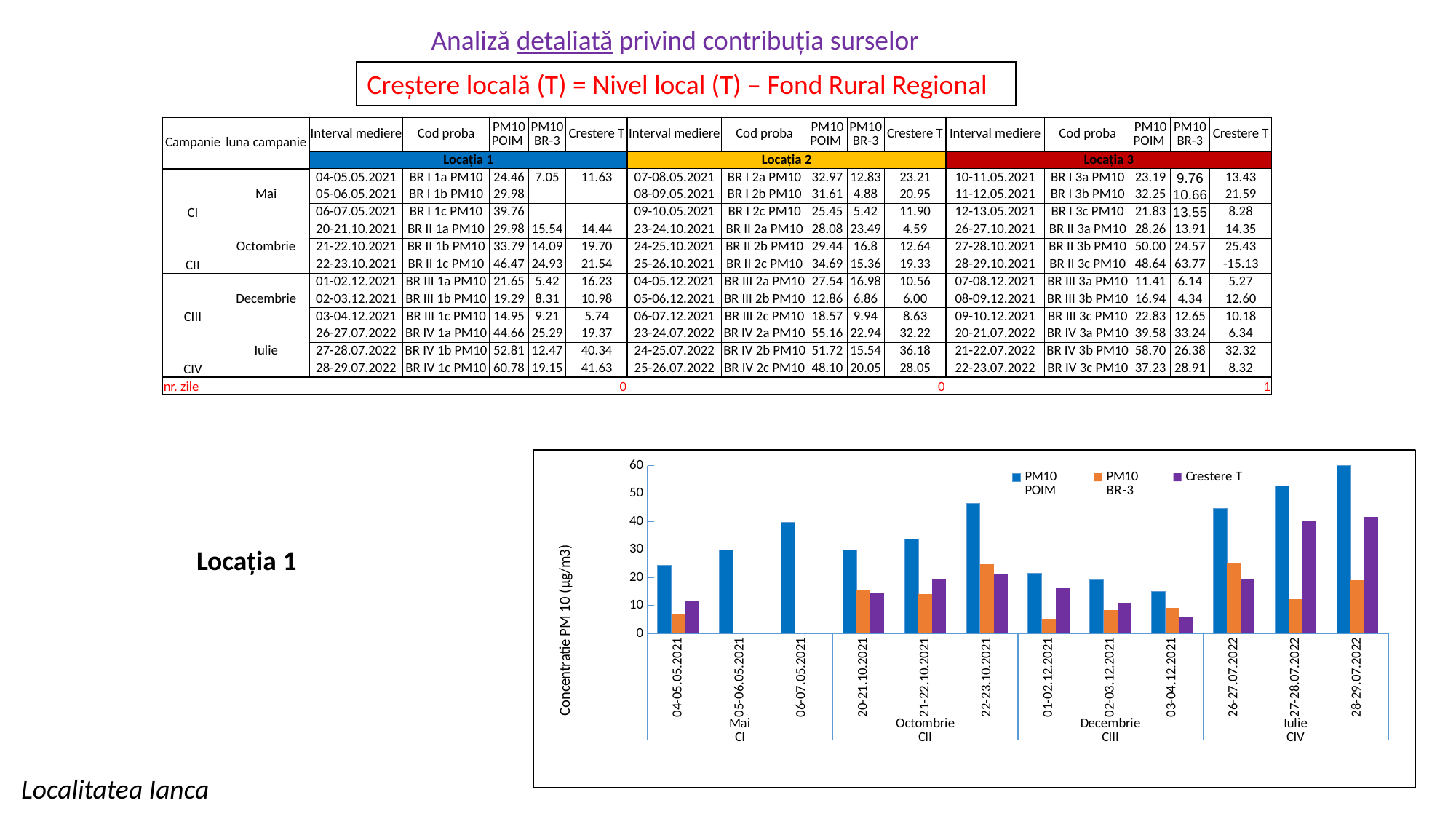
How many series does the chart legend list? 3 Is the Crestere T value for 27-28.07.2022 greater or less than 30? greater How many sampling intervals (categories) are plotted along the x axis of the chart? 12 Is the PM10 BR-3 value for 01-02.12.2021 greater or less than 10? less According to the table for Locația 1, what is the PM10 POIM value for 28-29.07.2022? 60.78 What is the label of the chart's vertical axis? Concentratie PM 10 (µg/m3) Is the PM10 POIM value for 22-23.10.2021 greater or less than 40? greater What kind of chart is shown on the slide? bar chart Do the PM10 POIM values rise or fall across the three Mai (CI) intervals in the chart? rise Which sampling interval has the lowest PM10 POIM value in the chart? 03-04.12.2021 Which is larger, the PM10 POIM value for 21-22.10.2021 or for 20-21.10.2021? 21-22.10.2021 Which sampling interval has the highest PM10 POIM value in the chart? 28-29.07.2022